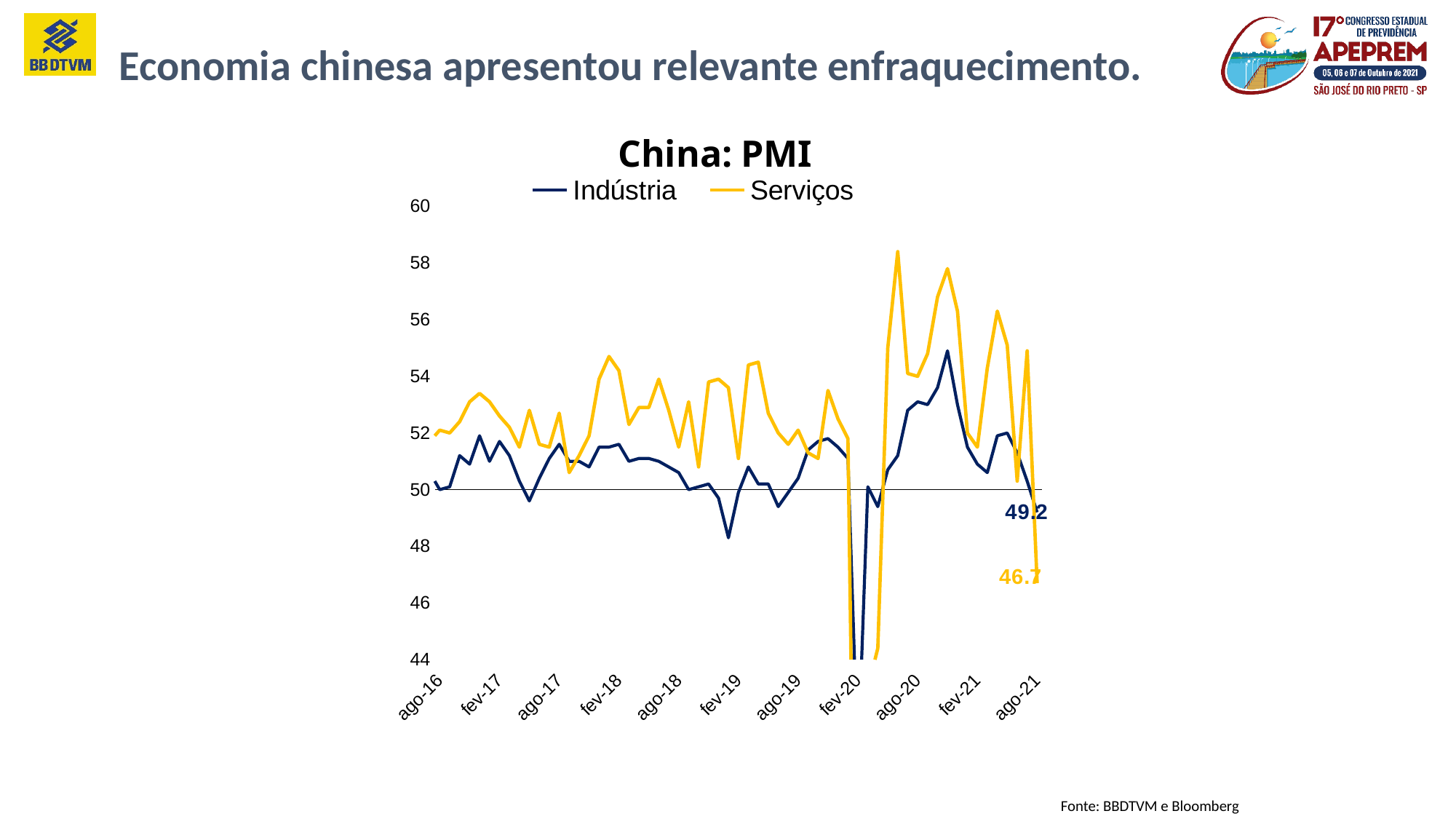
What is the last labelled value of the Serviços series? 46.7 Is the value of the Indústria series at fev-20 greater or less than 46? less Which series reaches the highest value anywhere on the chart? Serviços Between fev-21 and ago-21, does the Indústria line overall rise or fall? fall What is the last labelled value of the Indústria series? 49.2 How many series does the legend of the China: PMI chart list? 2 What is the title of the chart? China: PMI What colour is the line for the Serviços series? yellow What is the difference between the last labelled values of Indústria (49.2) and Serviços (46.7)? 2.5 What kind of chart is shown on the slide? line chart At the final point of the chart, which series has the larger value, Indústria or Serviços? Indústria Is the highest value reached by the Serviços series greater or less than 56? greater